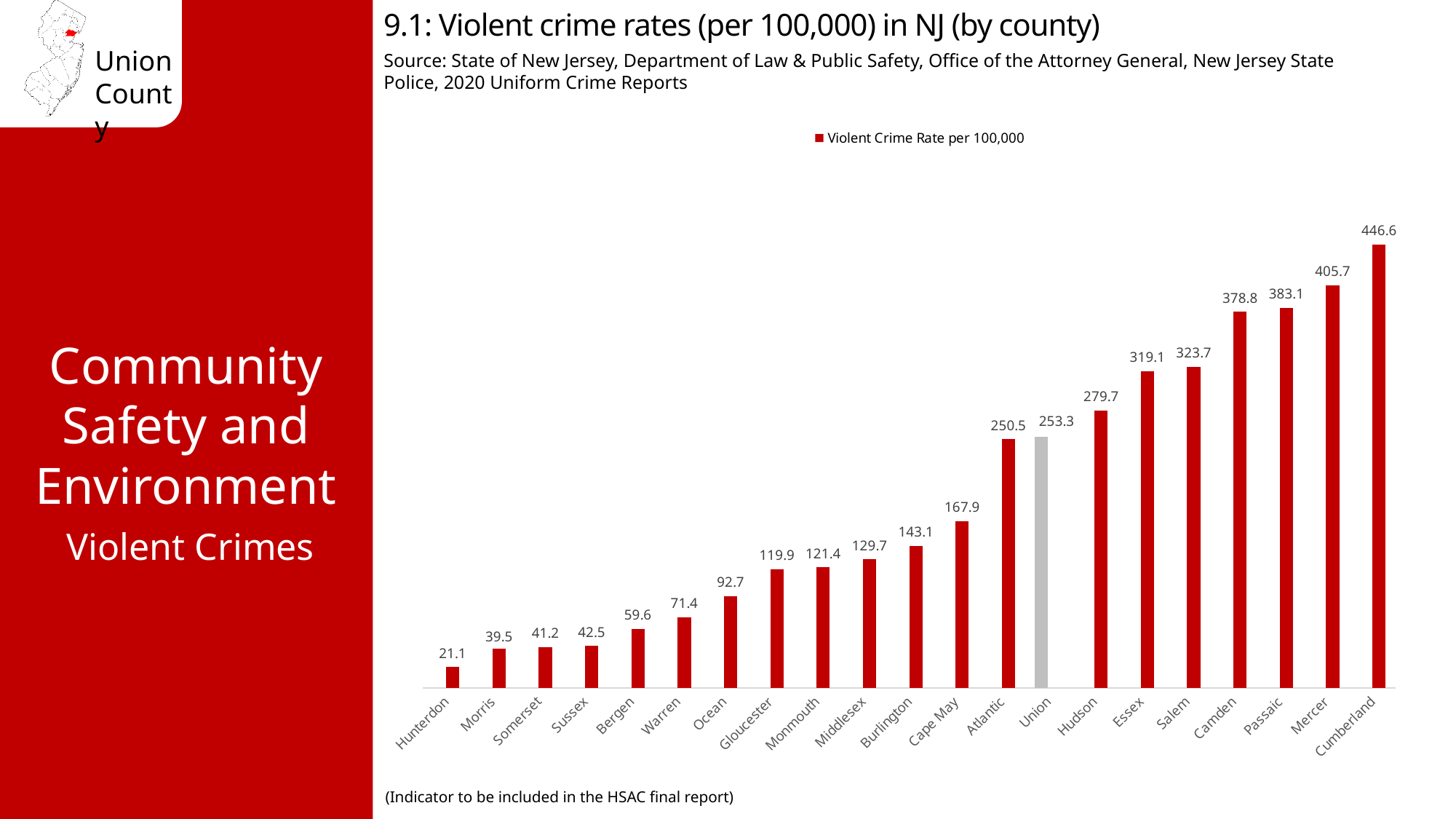
How many series does the legend list? 1 How many counties are shown in the chart? 21 What is the difference between the violent crime rates of Mercer and Passaic? 22.6 Which county has the highest violent crime rate? Cumberland Which county's bar is coloured grey instead of red? Union Which county has the lowest violent crime rate? Hunterdon What is the difference between the violent crime rates of Cumberland and Union? 193.3 What kind of chart is shown on the slide? Bar chart What is the violent crime rate per 100,000 for Union County? 253.3 Which county has a higher violent crime rate, Essex or Salem? Salem What is the violent crime rate per 100,000 for Hudson County? 279.7 Do the values rise or fall moving from left to right along the x axis? Rise